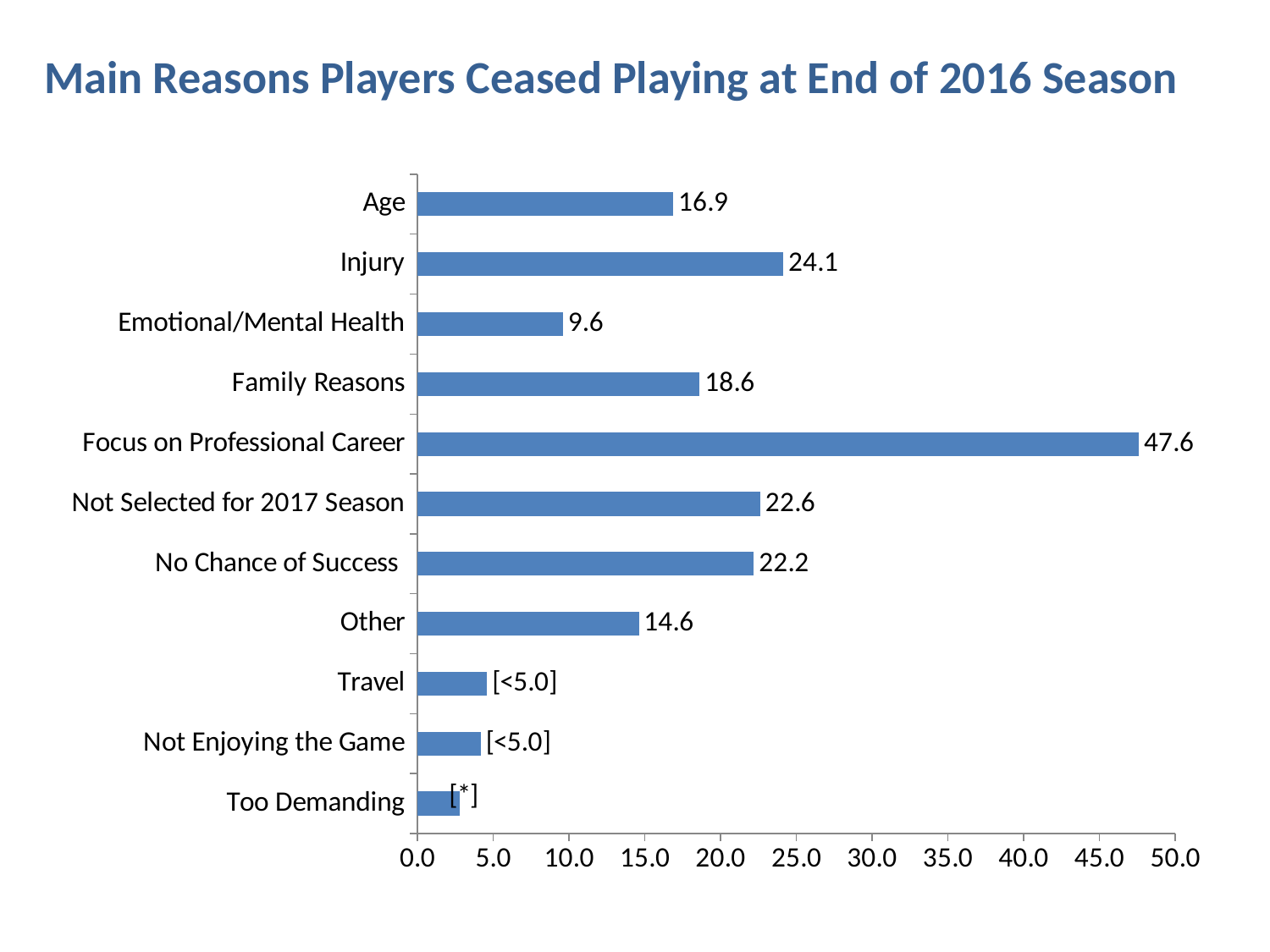
Which reason has the lowest value? Too Demanding Is the value for Travel greater or less than 5.0? less What is the value for Emotional/Mental Health? 9.6 What kind of chart is shown on the slide? bar chart How many reasons are shown on the chart? 11 What is the value for Injury? 24.1 What is the value for Not Selected for 2017 Season? 22.6 Which reason has the highest value? Focus on Professional Career Which is larger, the value for Family Reasons or the value for Other? Family Reasons What is the difference between the values for Injury and Age? 7.2 What is the title of the chart? Main Reasons Players Ceased Playing at End of 2016 Season What is the value for Focus on Professional Career? 47.6